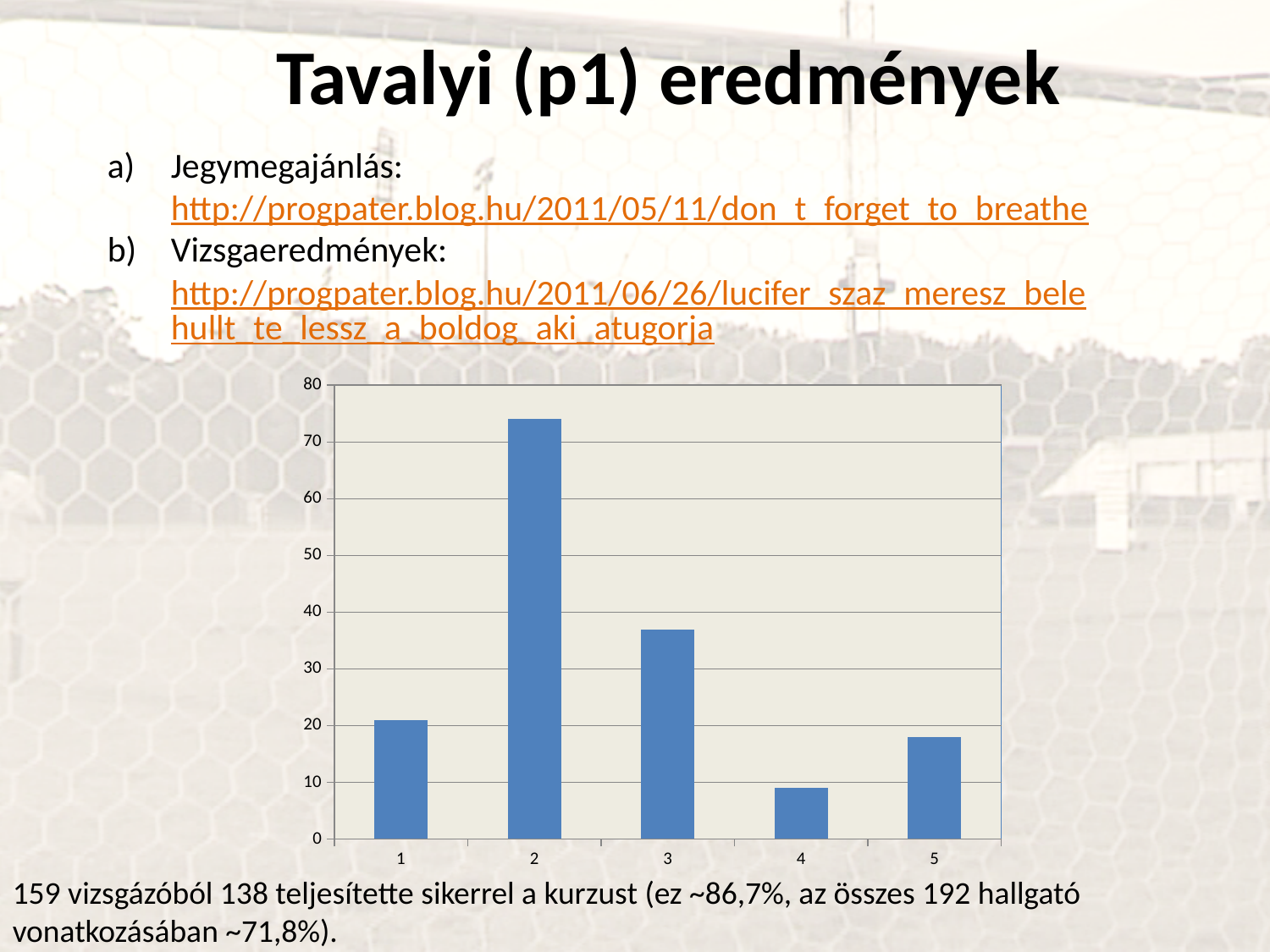
What kind of chart is shown on the slide? bar chart Which is larger, the value for category 5 or the value for category 4? 5 Which is larger, the value for category 1 or the value for category 3? 3 Is the value for category 3 greater or less than 30? greater Is the value for category 2 greater or less than 70? greater Which category has the lowest bar in the chart? 4 Is the value for category 3 greater or less than 40? less Which category has the highest bar in the chart? 2 How many categories are shown on the x axis of the chart? 5